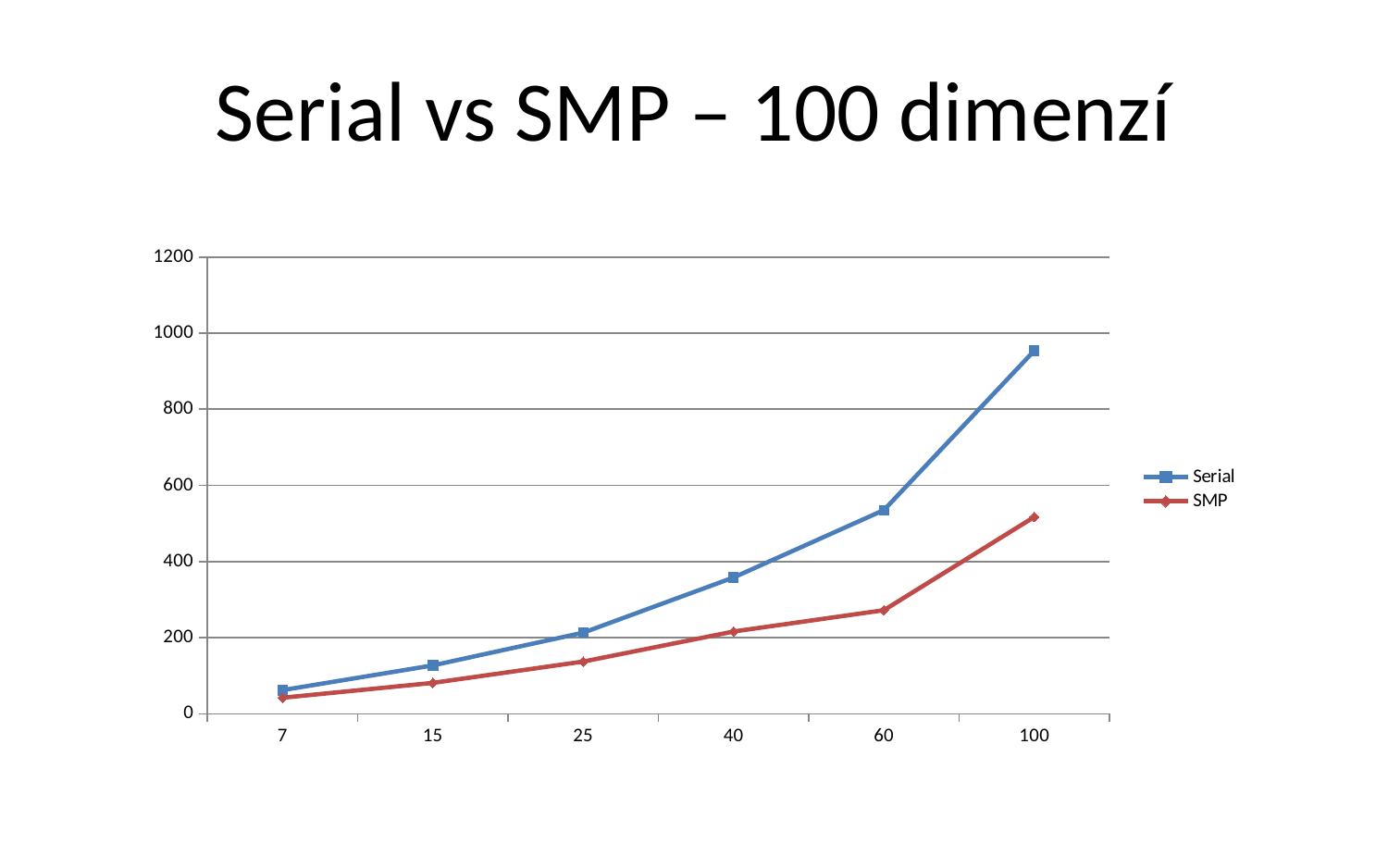
Is the value for SMP at x = 25 greater or less than 200? less Is the value for SMP at x = 60 greater or less than 400? less How many series does the legend list? 2 Is the value for Serial at x = 100 greater or less than 800? greater At x = 100, which series has the larger value, Serial or SMP? Serial How many points are plotted along the x axis for each series? 6 What kind of chart is shown on the slide? line chart Do the values of the Serial series rise or fall as the x axis goes from 7 to 100? rise What is the title of the chart on the slide? Serial vs SMP – 100 dimenzí At which x-axis category does the Serial series reach its highest value? 100 At which x-axis category does the SMP series have its lowest value? 7